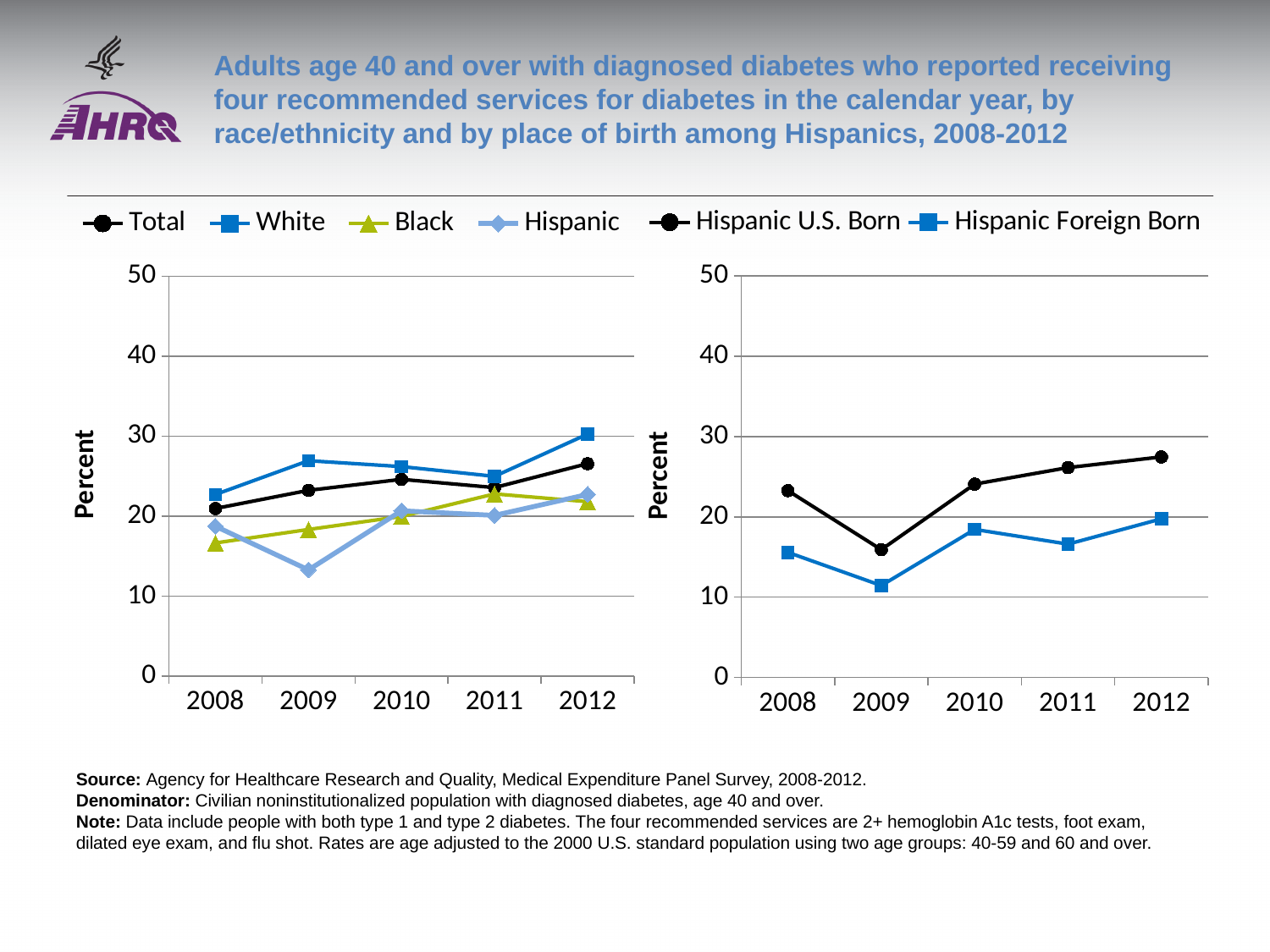
In the left chart, which series has the lowest value in 2009? Hispanic In the right chart, which series has the larger value in 2008, Hispanic U.S. Born or Hispanic Foreign Born? Hispanic U.S. Born What kind of chart is the left chart on the slide? line chart In the right chart, do the values for Hispanic U.S. Born rise or fall from 2009 to 2012? rise How many series does the legend list across the two charts? 6 In the right chart, is the value for Hispanic Foreign Born in 2009 greater or less than 20? less In the left chart, how many years are shown on the x axis? 5 In the left chart, is the value for Hispanic in 2009 greater or less than 20? less In the right chart, in which year is the value for Hispanic Foreign Born lowest? 2009 In the left chart, which series has the highest value in 2012? White In the left chart, is the value for White in 2012 greater or less than 20? greater What is the label on the y axis of the charts? Percent